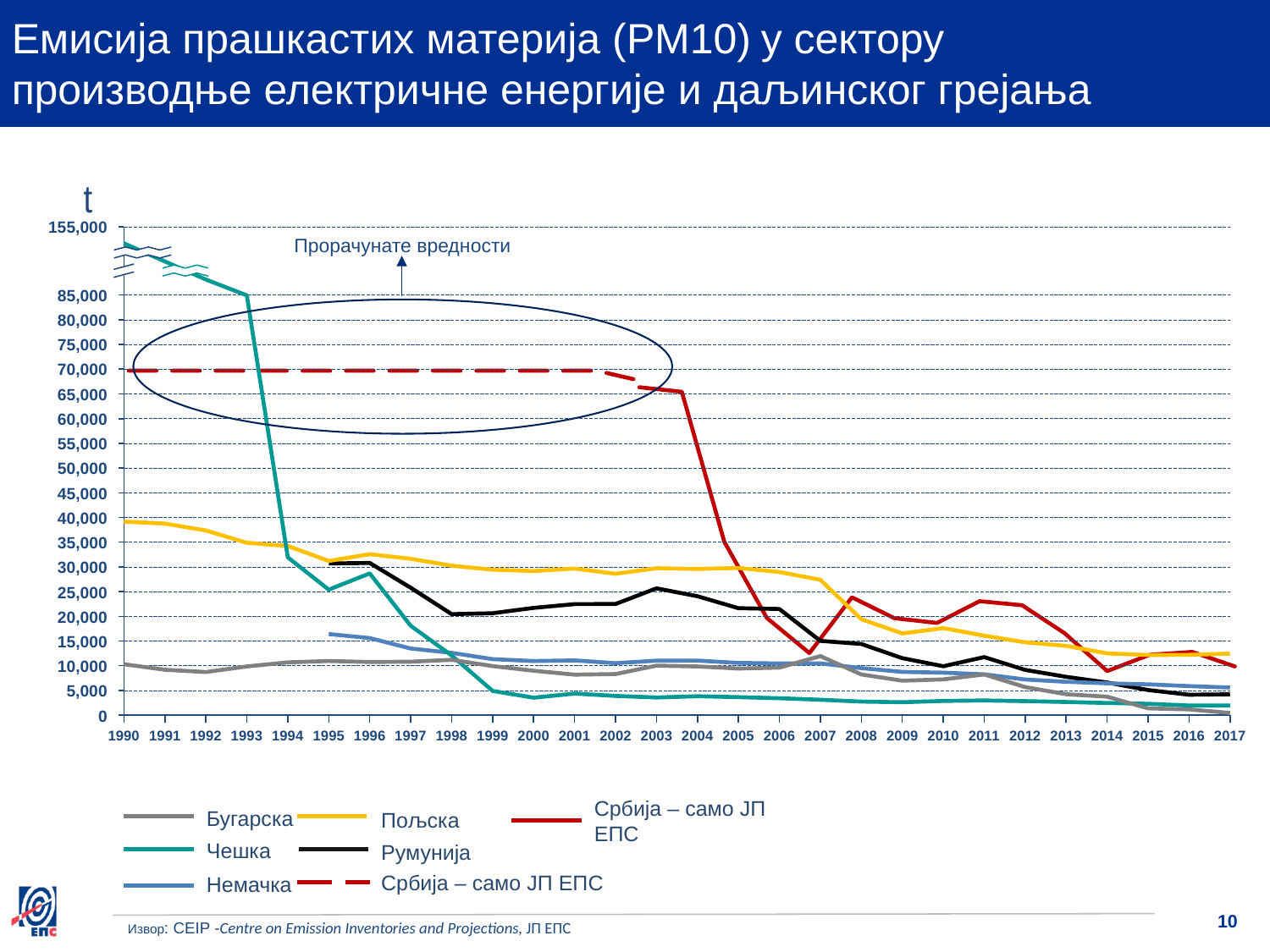
How many series does the legend list? 7 Does the value for Чешка rise or fall from 1990 to 2017? fall In 2011, which is higher: Србија – само ЈП ЕПС or Пољска? Србија – само ЈП ЕПС Is the value for Пољска in 1990 greater or less than 35,000? greater How many years are shown on the x axis? 28 Which series has the highest value in 1990? Чешка Is the value for Немачка in 2017 greater or less than 10,000? less What kind of chart is shown on the slide? line chart What text is written above the ellipse annotation on the chart? Прорачунате вредности Which series has the lowest value in 2017? Бугарска Is the value for Чешка in 1993 greater or less than 80,000? greater